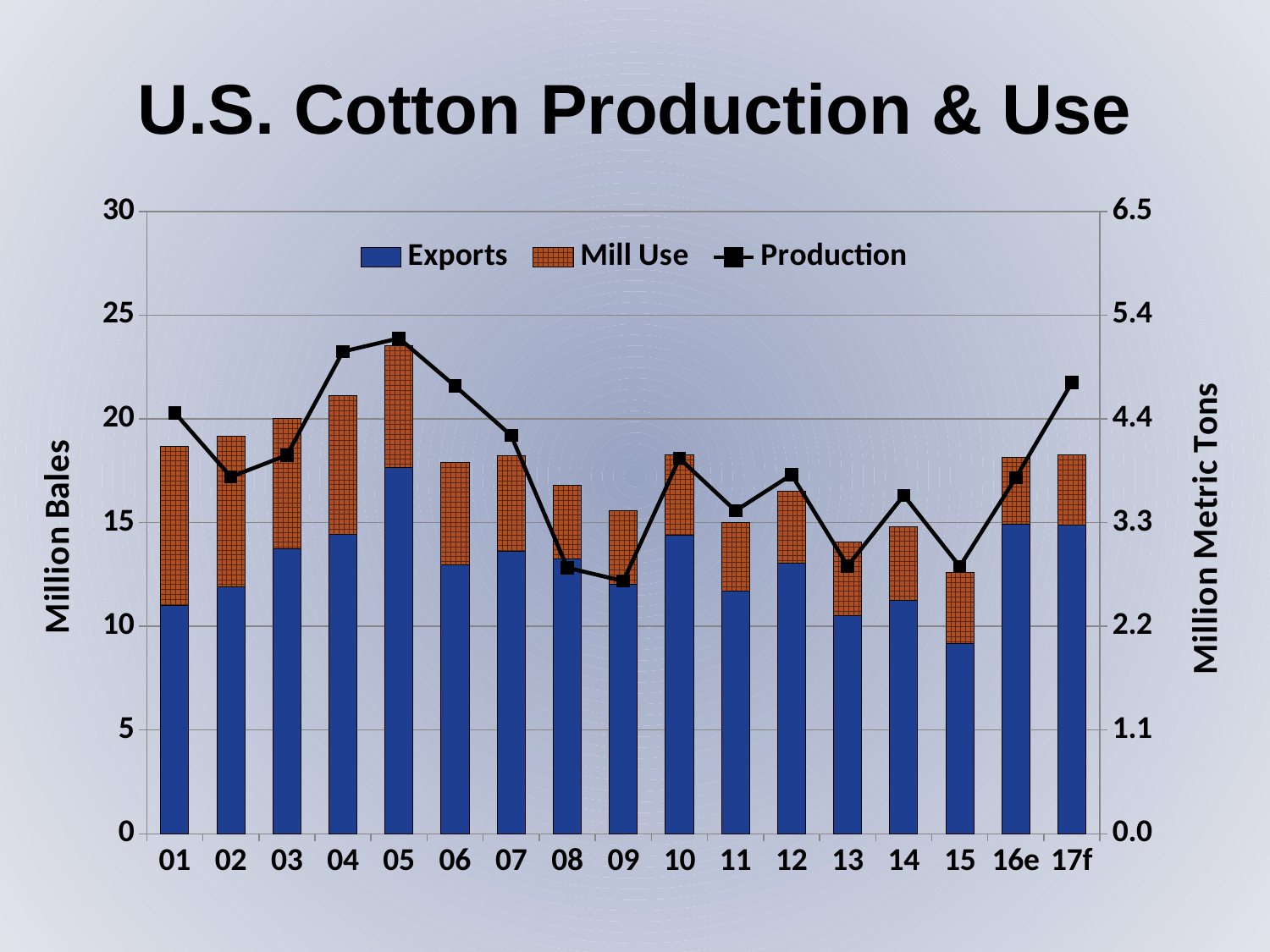
Is the Exports value for 15 greater or less than 10 million bales? less Does the Production line rise or fall from 05 to 09? Fall Which year has the larger Mill Use segment, 01 or 17f? 01 In which year is the Exports bar the tallest? 05 How many series does the legend list? 3 Is the Production value for 09 greater or less than 3.3 million metric tons? less In which year does the Production line reach its highest point? 05 In which year is the Exports bar the shortest? 15 Is the Exports value for 05 greater or less than 15 million bales? greater In which year does the Production line reach its lowest point? 09 How many years (categories) are shown on the x axis? 17 What kind of chart is shown on the slide? A stacked bar chart with a line